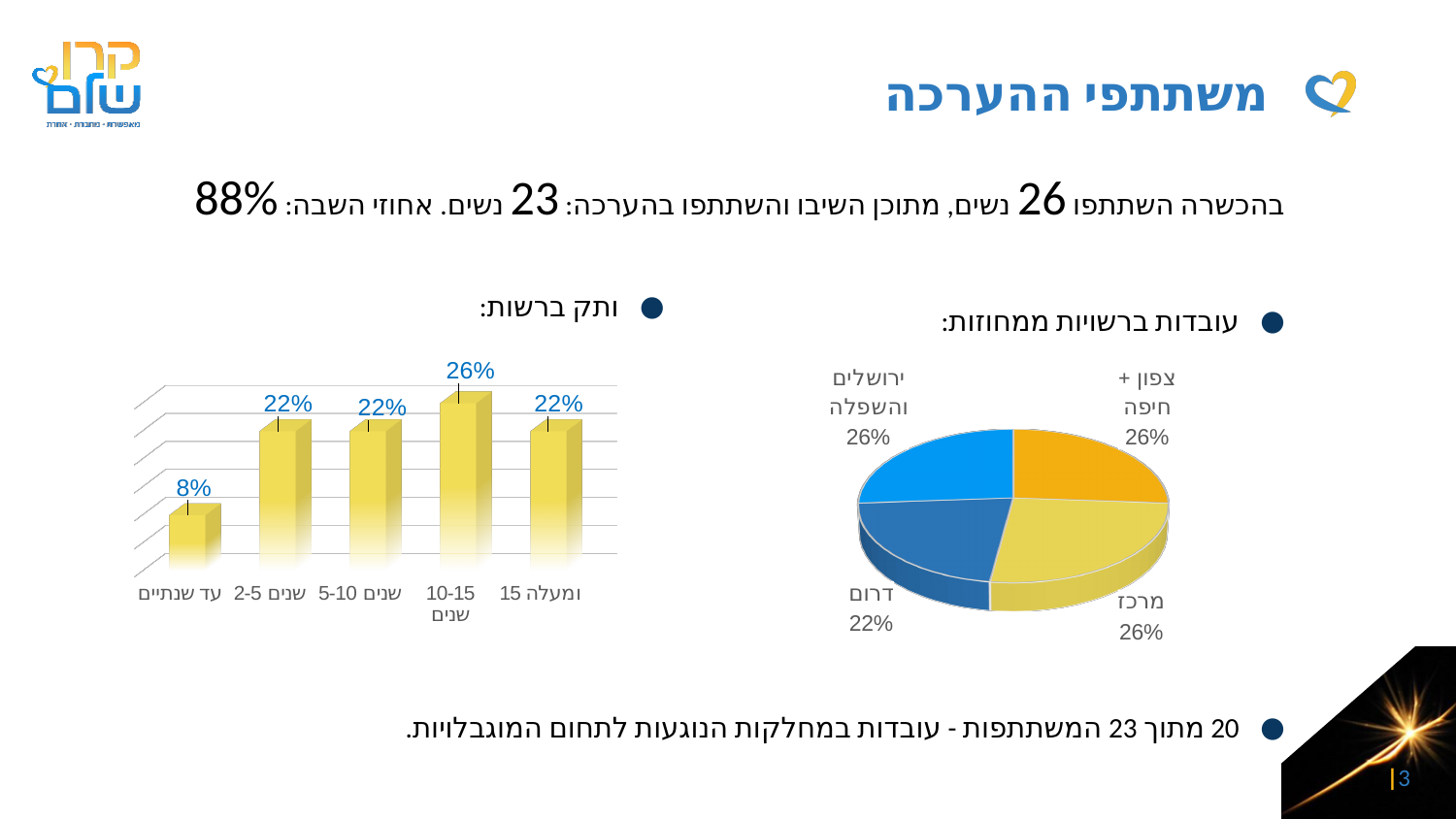
In the bar chart 'ותק ברשות' on the left, what is the value for 'עד שנתיים'? 8% In the bar chart 'ותק ברשות' on the left, how many categories are shown? 5 In the bar chart 'ותק ברשות' on the left, which category has the highest value? 10-15 שנים In the pie chart 'עובדות ברשויות ממחוזות' on the right, which slice is the smallest? דרום In the pie chart 'עובדות ברשויות ממחוזות' on the right, what is the share for 'דרום'? 22% What kind of chart is the chart on the right of the slide ('עובדות ברשויות ממחוזות')? Pie chart In the pie chart 'עובדות ברשויות ממחוזות' on the right, what is the share for 'מרכז'? 26% What kind of chart is the chart on the left of the slide ('ותק ברשות')? Bar chart In the bar chart 'ותק ברשות' on the left, what is the difference between the values for '10-15 שנים' and 'עד שנתיים'? 18% In the pie chart 'עובדות ברשויות ממחוזות' on the right, how many slices are there? 4 In the bar chart 'ותק ברשות' on the left, what is the value for '10-15 שנים'? 26% In the bar chart 'ותק ברשות' on the left, which category has the lowest value? עד שנתיים